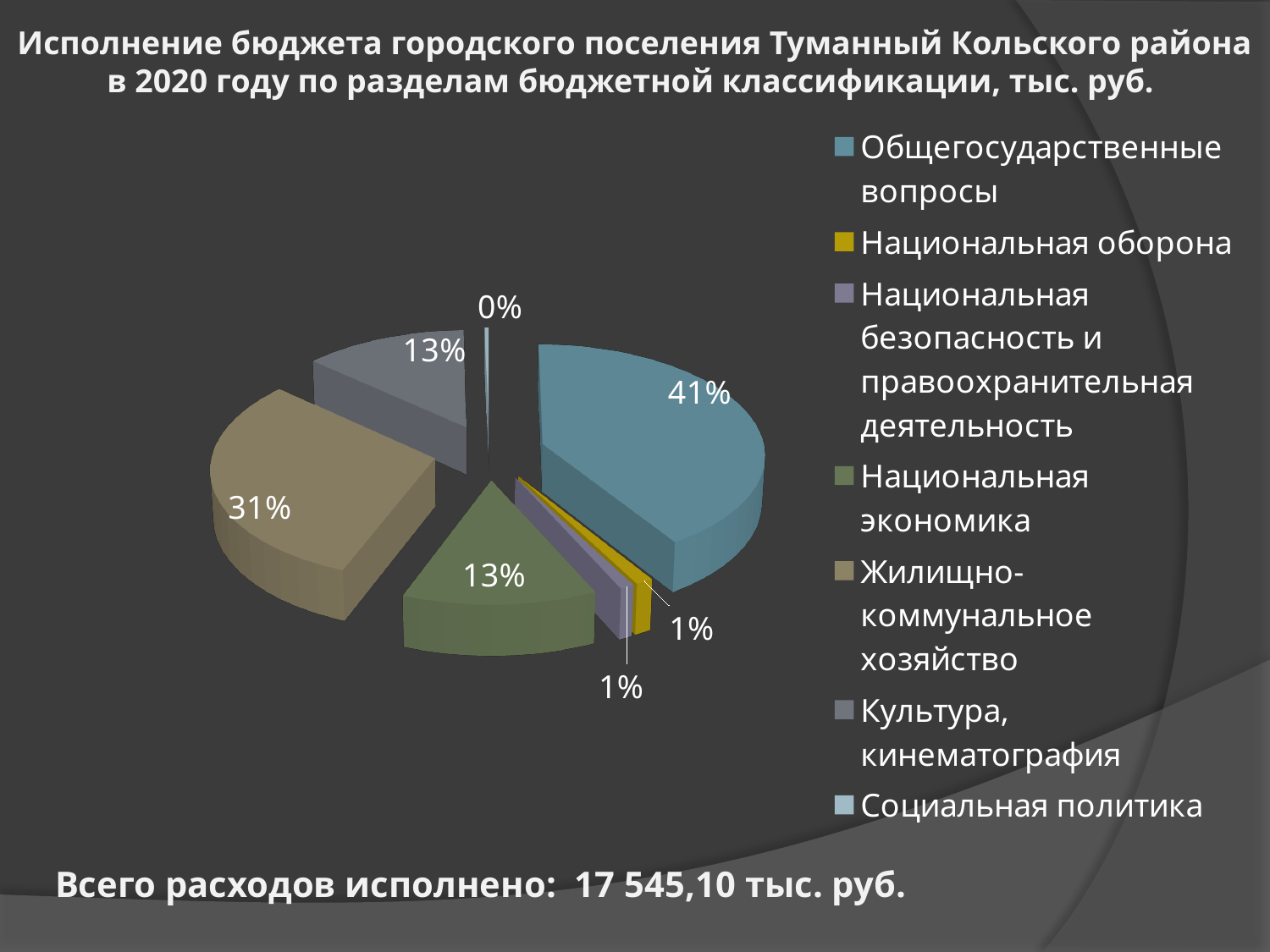
Which category has the largest share of the pie? Общегосударственные вопросы Which category has the smallest share of the pie? Социальная политика What share of the pie does Жилищно-коммунальное хозяйство have? 31% What total expenditure amount is stated below the chart? 17 545,10 тыс. руб. What share of the pie does Национальная оборона have? 1% What share of the pie does Национальная экономика have? 13% What kind of chart is shown on the slide? pie chart By how many percentage points does the share of Общегосударственные вопросы exceed that of Жилищно-коммунальное хозяйство? 10 How many categories does the legend of the pie chart list? 7 Which has the larger share: Национальная экономика or Жилищно-коммунальное хозяйство? Жилищно-коммунальное хозяйство